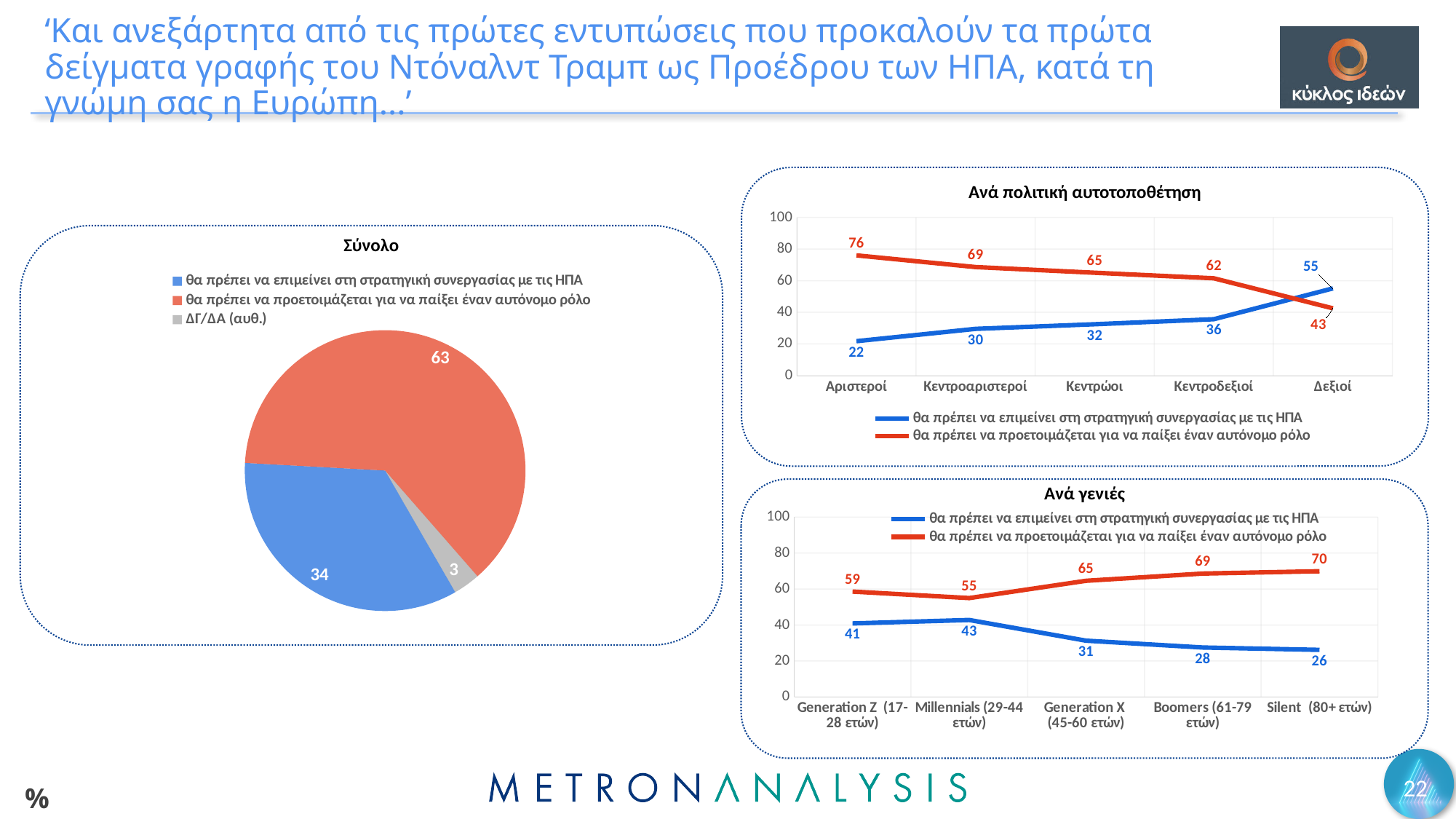
How many series does the legend of the 'Ανά γενιές' chart list? 2 In the 'Ανά γενιές' chart, which category has the lowest value for 'θα πρέπει να επιμείνει στη στρατηγική συνεργασίας με τις ΗΠΑ'? Silent (80+ ετών) In the 'Ανά πολιτική αυτοτοποθέτηση' chart, which category has the highest value for 'θα πρέπει να επιμείνει στη στρατηγική συνεργασίας με τις ΗΠΑ'? Δεξιοί In the 'Ανά πολιτική αυτοτοποθέτηση' chart, what is the value of 'θα πρέπει να προετοιμάζεται για να παίξει έναν αυτόνομο ρόλο' for 'Αριστεροί'? 76 In the 'Σύνολο' pie chart, what is the difference between the value for 'θα πρέπει να προετοιμάζεται για να παίξει έναν αυτόνομο ρόλο' and the value for 'θα πρέπει να επιμείνει στη στρατηγική συνεργασίας με τις ΗΠΑ'? 29 In the 'Ανά γενιές' chart, what is the value of 'θα πρέπει να προετοιμάζεται για να παίξει έναν αυτόνομο ρόλο' for 'Silent (80+ ετών)'? 70 In the 'Σύνολο' pie chart, what is the value for 'ΔΓ/ΔΑ (αυθ.)'? 3 What kind of chart is the 'Σύνολο' chart? Pie chart In the 'Ανά πολιτική αυτοτοποθέτηση' chart, does the value of 'θα πρέπει να επιμείνει στη στρατηγική συνεργασίας με τις ΗΠΑ' rise or fall from 'Αριστεροί' to 'Δεξιοί'? Rise In the 'Σύνολο' pie chart, what is the value for 'θα πρέπει να προετοιμάζεται για να παίξει έναν αυτόνομο ρόλο'? 63 In the 'Ανά γενιές' chart, what is the difference between the two series for 'Generation X (45-60 ετών)'? 34 How many categories are shown on the x axis of the 'Ανά πολιτική αυτοτοποθέτηση' chart? 5